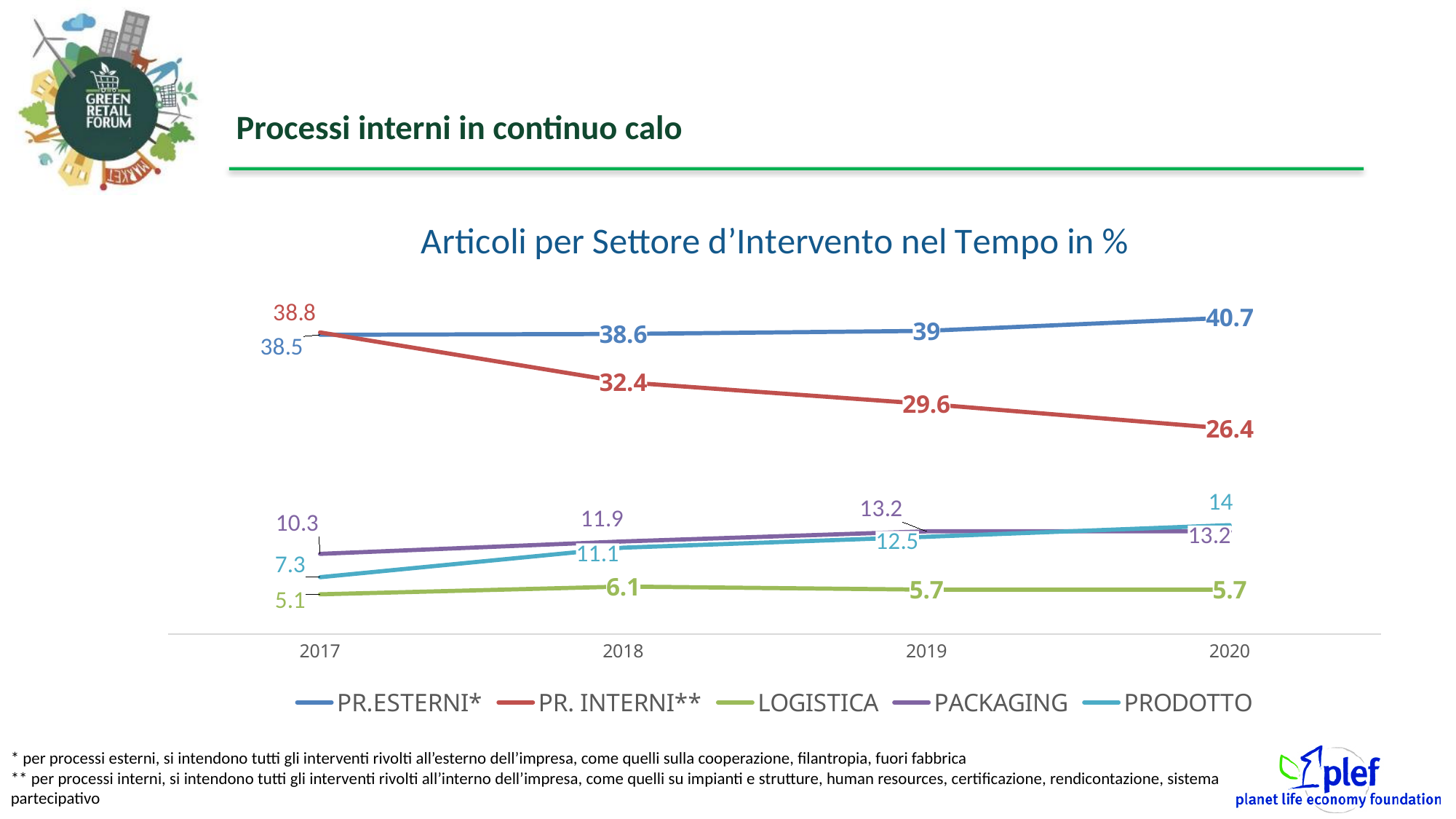
Does the PR. INTERNI** series rise or fall from 2017 to 2020? Fall In which year is the PR. INTERNI** value highest? 2017 How many series does the legend list? 5 What is the value for PRODOTTO in 2018? 11.1 Which is larger in 2017: PR. INTERNI** or PR.ESTERNI*? PR. INTERNI** What kind of chart is shown on the slide? Line chart How many years are shown on the x axis? 4 What is the value for PACKAGING in 2019? 13.2 What is the value for PR. INTERNI** in 2020? 26.4 What is the difference between the PR.ESTERNI* and PR. INTERNI** values in 2020? 14.3 In which year is the LOGISTICA value lowest? 2017 What is the value for PR.ESTERNI* in 2017? 38.5